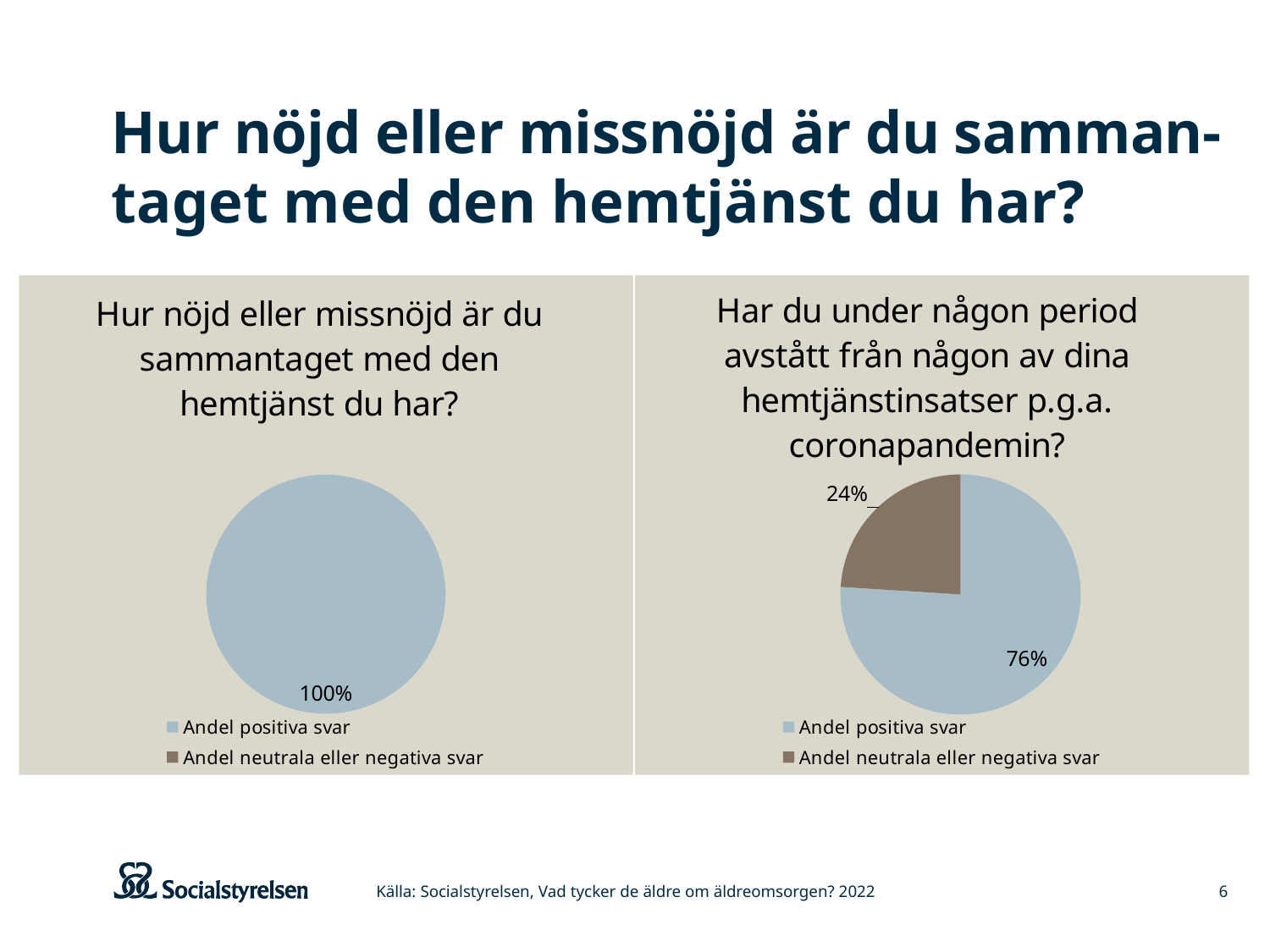
What kind of chart is the left chart? Pie chart What is the title of the right chart? Har du under någon period avstått från någon av dina hemtjänstinsatser p.g.a. coronapandemin? How many slices with a data label are visible in the right chart? 2 In the right chart, which slice is the smallest? Andel neutrala eller negativa svar In the right chart, which is larger: Andel positiva svar or Andel neutrala eller negativa svar? Andel positiva svar How many series does the legend of the right chart list? 2 In the right chart, which slice is the largest? Andel positiva svar In the right chart, what share is labelled for Andel neutrala eller negativa svar? 24% In the right chart, what colour is the Andel neutrala eller negativa svar slice? Brown In the right chart, what share is labelled for Andel positiva svar? 76% In the right chart, what is the difference between the Andel positiva svar share and the Andel neutrala eller negativa svar share? 52% In the left chart, what share is labelled for Andel positiva svar? 100%